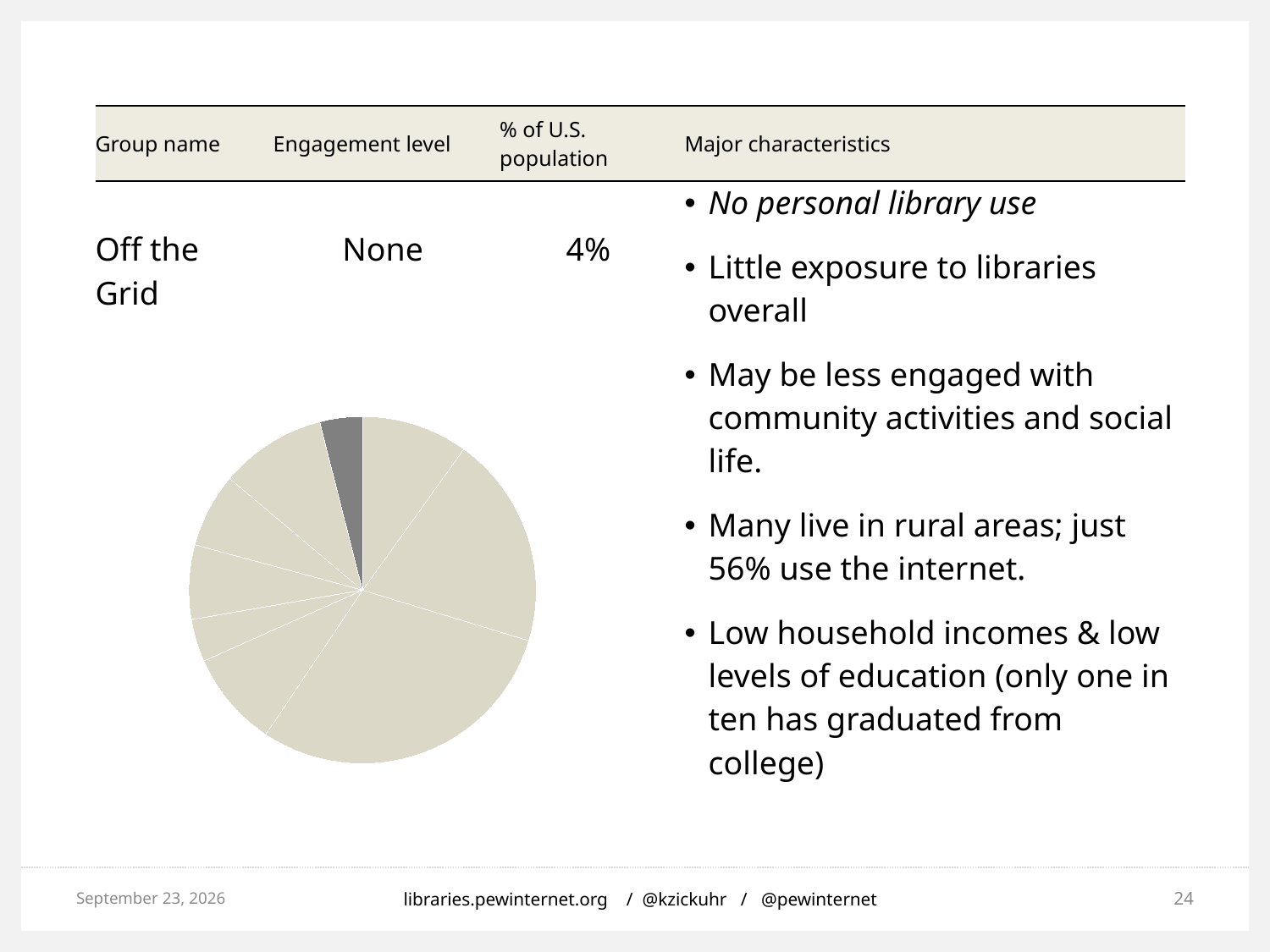
What colour is the highlighted slice in the pie chart? dark gray What share of the U.S. population does the dark gray highlighted slice of the pie chart represent? 4% Does the pie chart include a legend? No What kind of chart is shown on the slide? pie chart